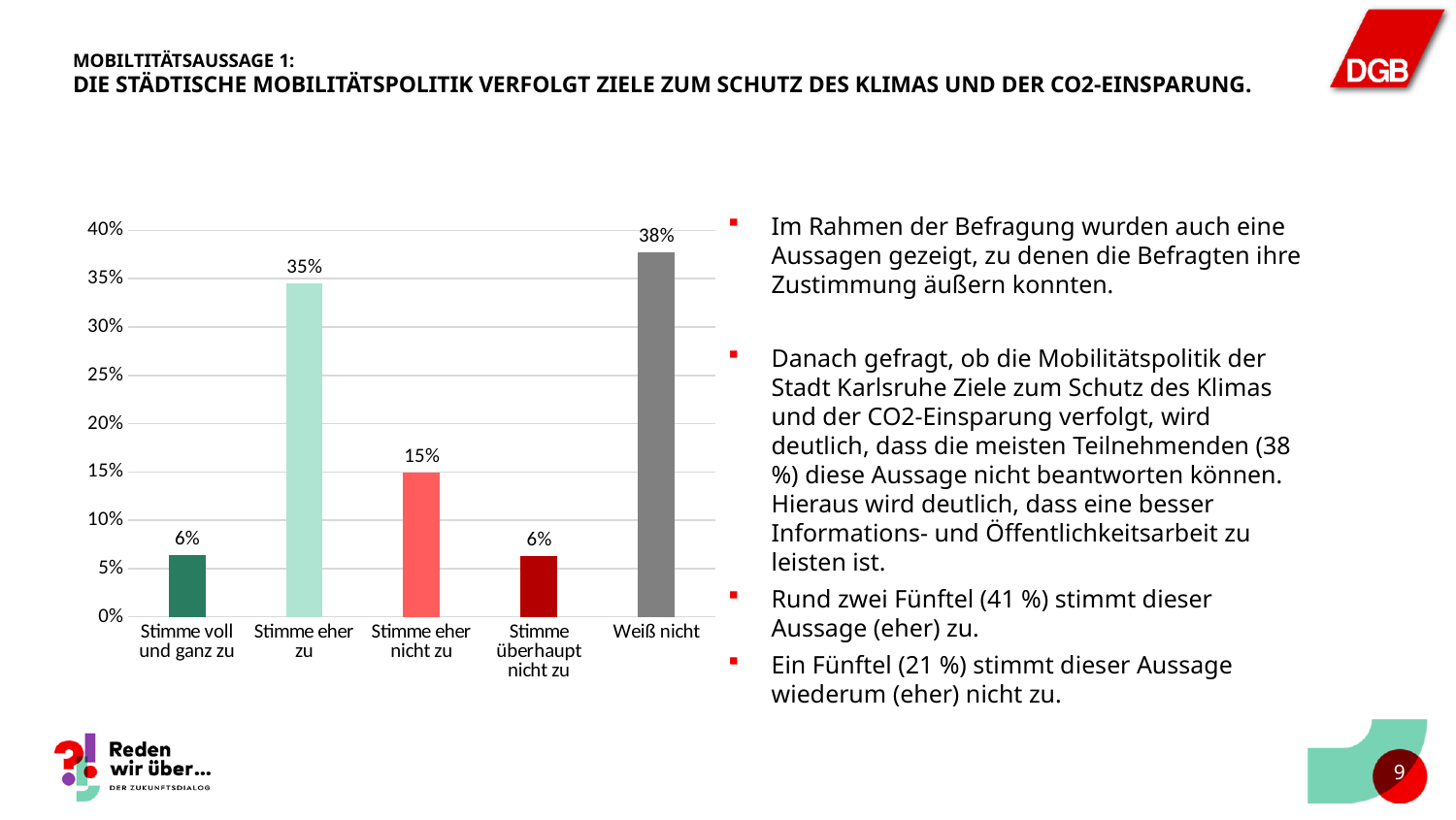
What is the difference between "Stimme eher zu" and "Stimme eher nicht zu"? 20% What is the value for "Stimme eher zu"? 35% What kind of chart is shown on the slide? bar chart What is the difference between "Weiß nicht" and "Stimme eher zu"? 3% What colour is the bar for "Weiß nicht"? grey What is the value for "Stimme eher nicht zu"? 15% How many categories are shown on the x axis? 5 Is the value for "Stimme eher nicht zu" greater or less than 20%? less Which is larger, "Stimme eher zu" or "Stimme eher nicht zu"? Stimme eher zu Which category has the highest value? Weiß nicht What is the value for "Stimme voll und ganz zu"? 6% What percentage of respondents answered "Weiß nicht"? 38%